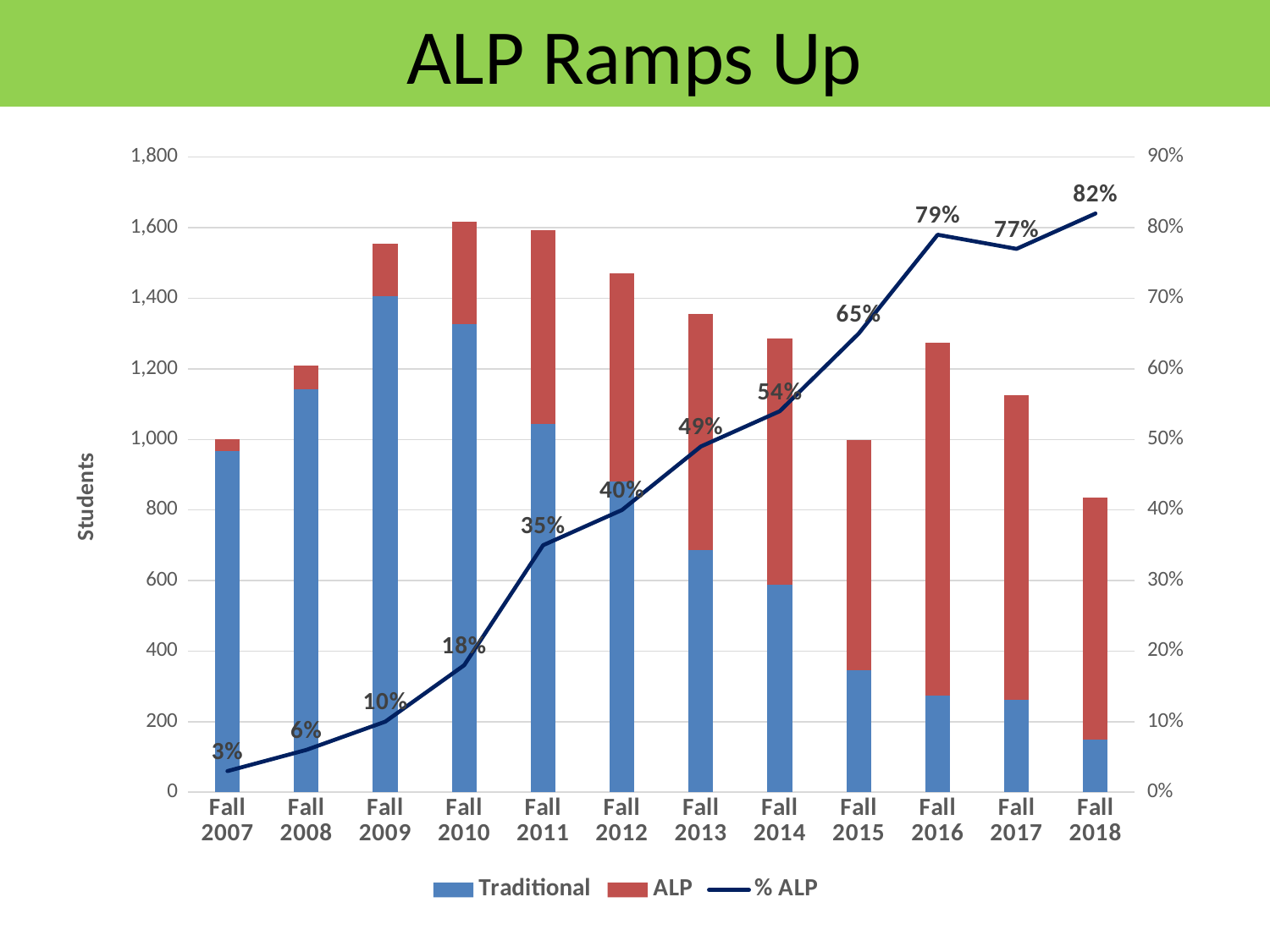
Is the Traditional value for Fall 2018 greater or less than 200 students? less Is the total height of the stacked bar for Fall 2009 greater or less than 1,400 students? greater How many series does the legend list? 3 What is the % ALP value for Fall 2007? 3% What is the % ALP value for Fall 2018? 82% By how many percentage points does the % ALP value for Fall 2018 exceed the value for Fall 2007? 79 percentage points Which term has the highest % ALP value? Fall 2018 Which has the larger % ALP value, Fall 2016 or Fall 2017? Fall 2016 Does the % ALP line rise or fall overall from Fall 2007 to Fall 2018? rises What is the % ALP value for Fall 2012? 40% How many terms are shown on the x axis? 12 Which term has the lowest % ALP value? Fall 2007